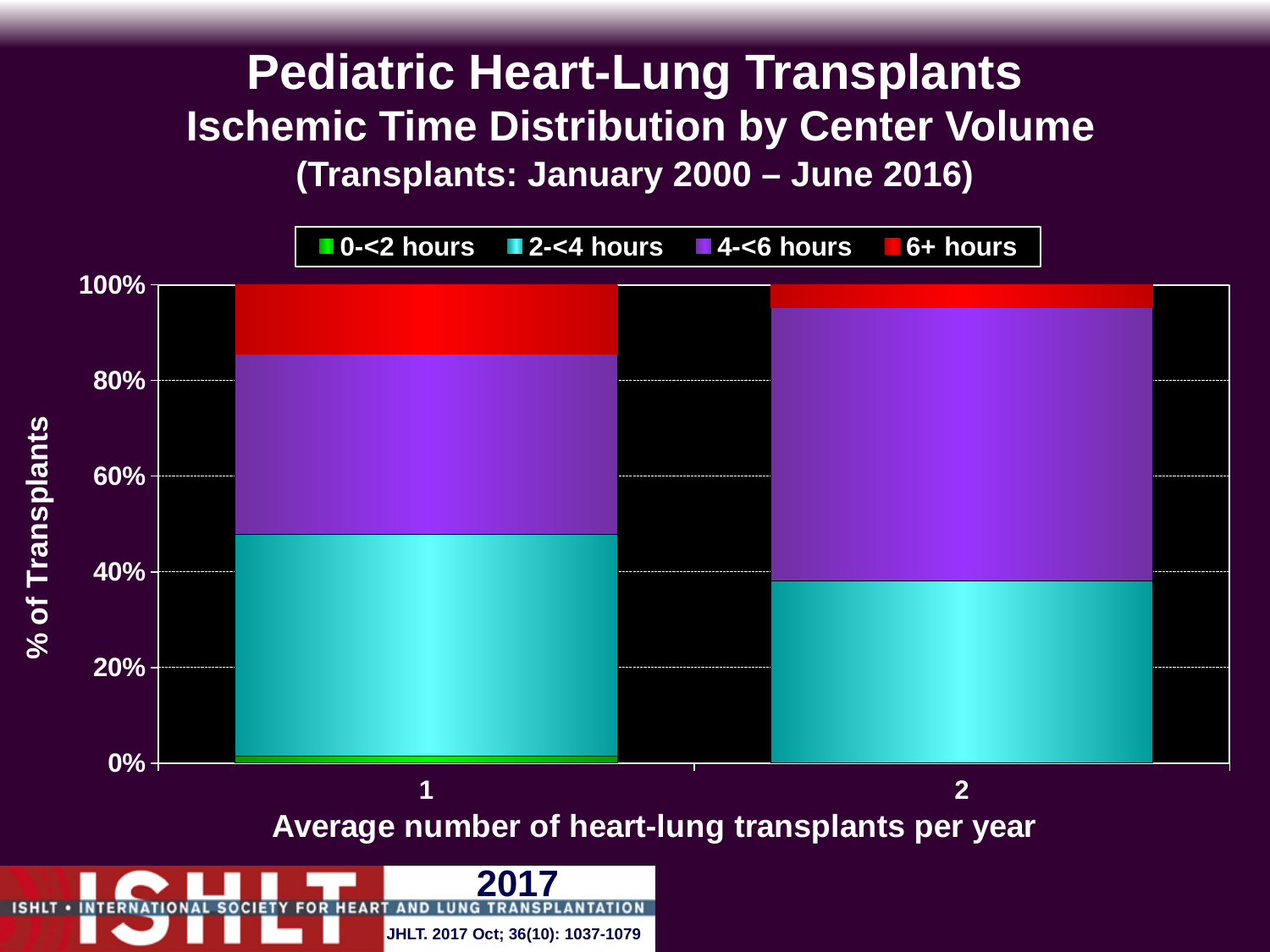
How many categories are shown on the x axis? 2 What is the total height of the stacked bar for category 1? 100% How many series does the legend list? 4 Is the 4-<6 hours share for category 2 greater or less than 40%? greater Is the 6+ hours share for category 1 greater or less than 20%? less Which category has the larger 4-<6 hours share, 1 or 2? 2 What kind of chart is shown on the slide? Stacked bar chart Is the 2-<4 hours share for category 1 greater or less than 40%? greater What is the label of the x axis? Average number of heart-lung transplants per year Which category has the larger 2-<4 hours share, 1 or 2? 1 Which legend entry is shown in red? 6+ hours Which category has the larger 6+ hours share, 1 or 2? 1